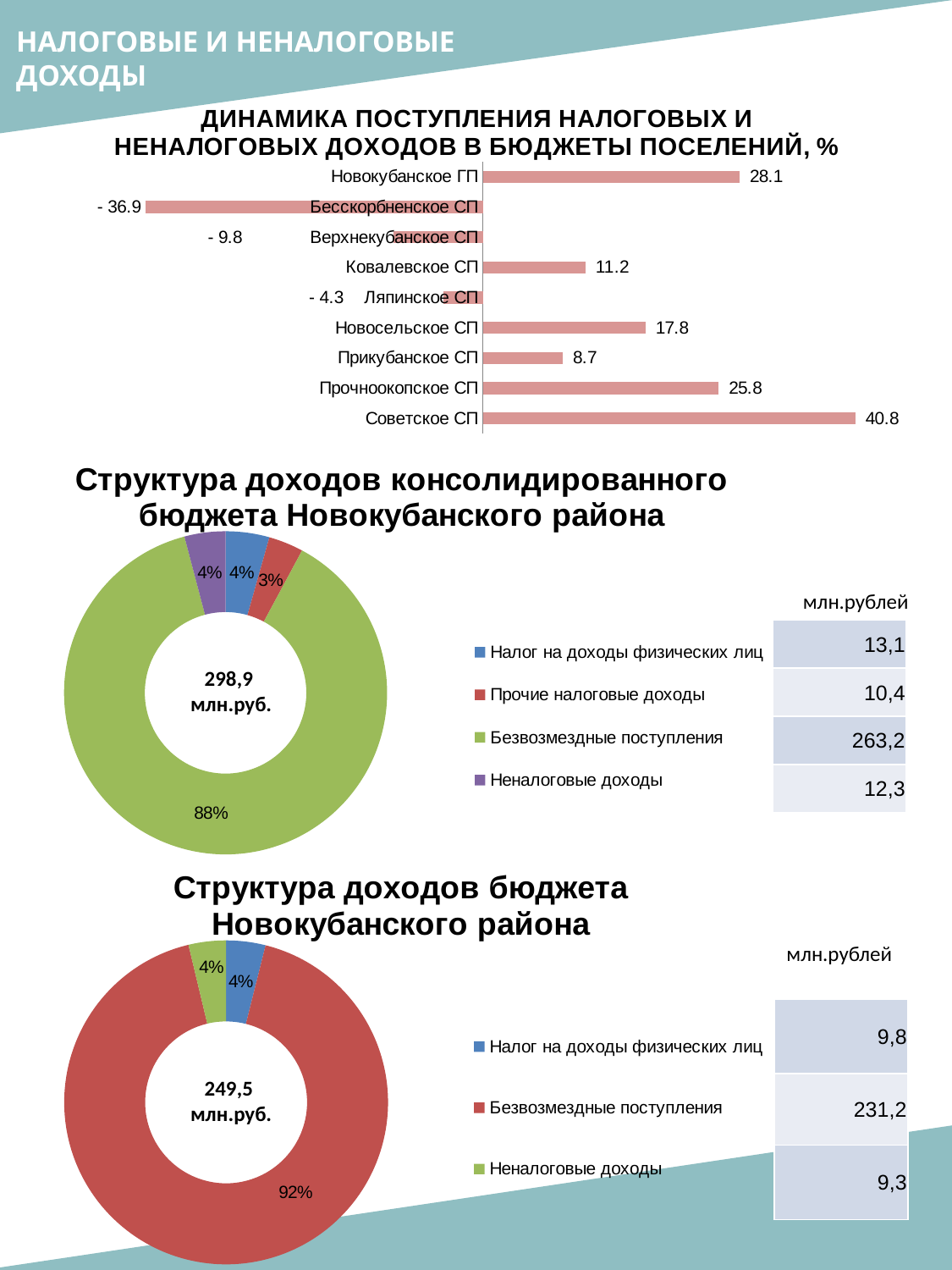
In the chart 'Структура доходов консолидированного бюджета Новокубанского района', what share does Безвозмездные поступления have? 88% In the bar chart 'Динамика поступления налоговых и неналоговых доходов в бюджеты поселений, %', what is the difference between the values for Новокубанское ГП and Прикубанское СП? 19.4 In the bar chart 'Динамика поступления налоговых и неналоговых доходов в бюджеты поселений, %', what is the value for Советское СП? 40.8 In the bar chart 'Динамика поступления налоговых и неналоговых доходов в бюджеты поселений, %', which settlement has the highest value? Советское СП In the bar chart 'Динамика поступления налоговых и неналоговых доходов в бюджеты поселений, %', which settlement has the lowest value? Бесскорбненское СП In the chart 'Структура доходов консолидированного бюджета Новокубанского района', what is the value for Безвозмездные поступления in млн.рублей? 263,2 How many categories does the legend list in the chart 'Структура доходов консолидированного бюджета Новокубанского района'? 4 In the chart 'Структура доходов бюджета Новокубанского района', what is the total shown in the centre of the doughnut? 249,5 млн.руб. In the bar chart 'Динамика поступления налоговых и неналоговых доходов в бюджеты поселений, %', what is the value for Бесскорбненское СП? - 36.9 What type of chart is 'Динамика поступления налоговых и неналоговых доходов в бюджеты поселений, %'? Bar chart How many settlements are shown in the bar chart 'Динамика поступления налоговых и неналоговых доходов в бюджеты поселений, %'? 9 In the bar chart 'Динамика поступления налоговых и неналоговых доходов в бюджеты поселений, %', which is larger: the value for Прочноокопское СП or Новосельское СП? Прочноокопское СП